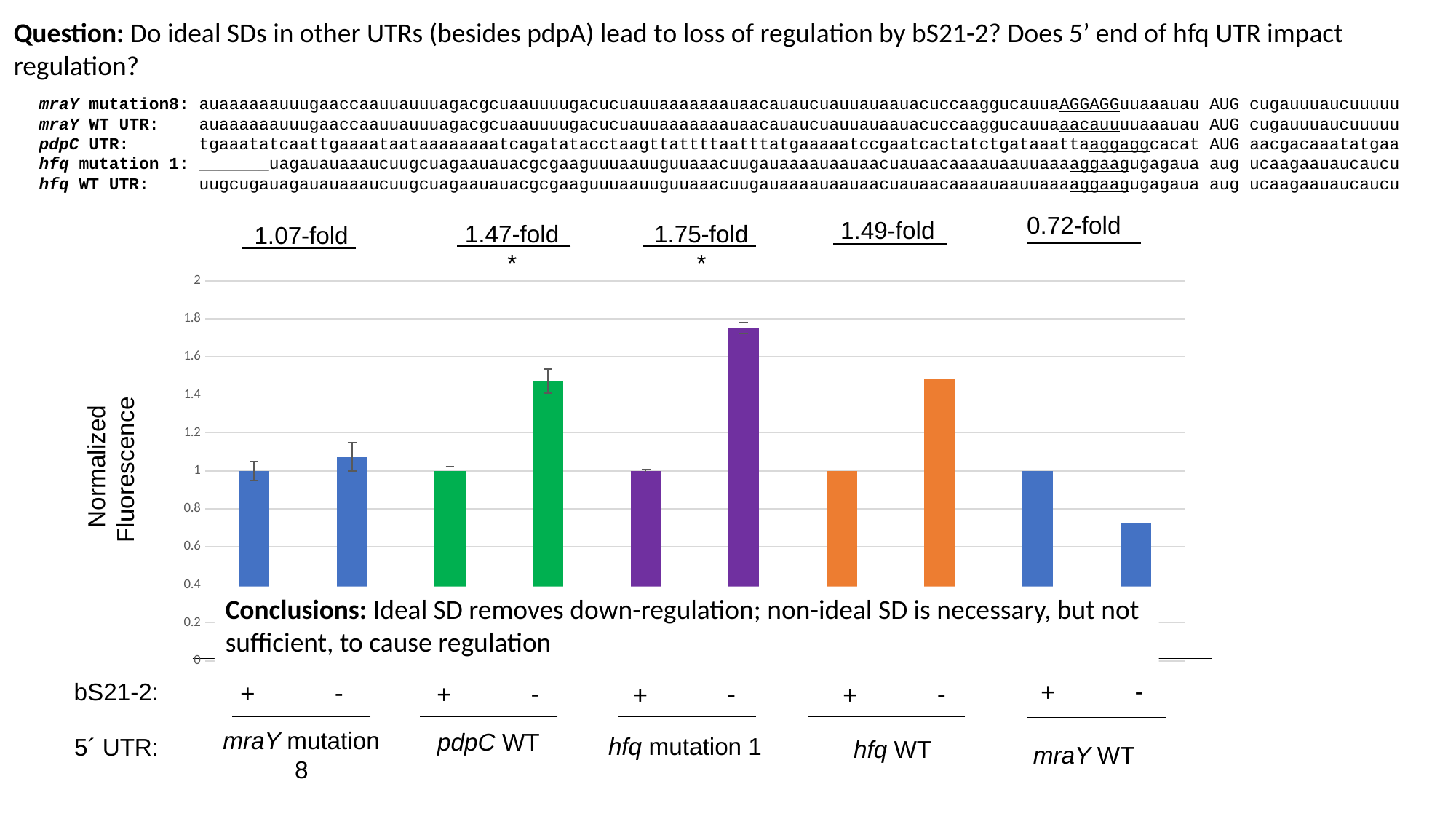
What is the difference between the fold change for hfq mutation 1 and the fold change for mraY WT? 1.03 Which 5' UTR group has the lowest fold change? mraY WT Which 5' UTR group has the highest fold change? hfq mutation 1 What fold change is printed above the mraY WT group? 0.72-fold What is the label on the y axis of the chart? Normalized Fluorescence Is the normalized fluorescence for mraY WT without bS21-2 (-) greater or less than 0.8? less What kind of chart is shown on the slide? bar chart How many 5' UTR groups are shown along the x axis of the chart? 5 How many bars are plotted in the chart? 10 Is the normalized fluorescence for hfq WT without bS21-2 (-) greater or less than 1.4? greater What fold change is printed above the pdpC WT group? 1.47-fold What fold change is printed above the hfq mutation 1 group? 1.75-fold